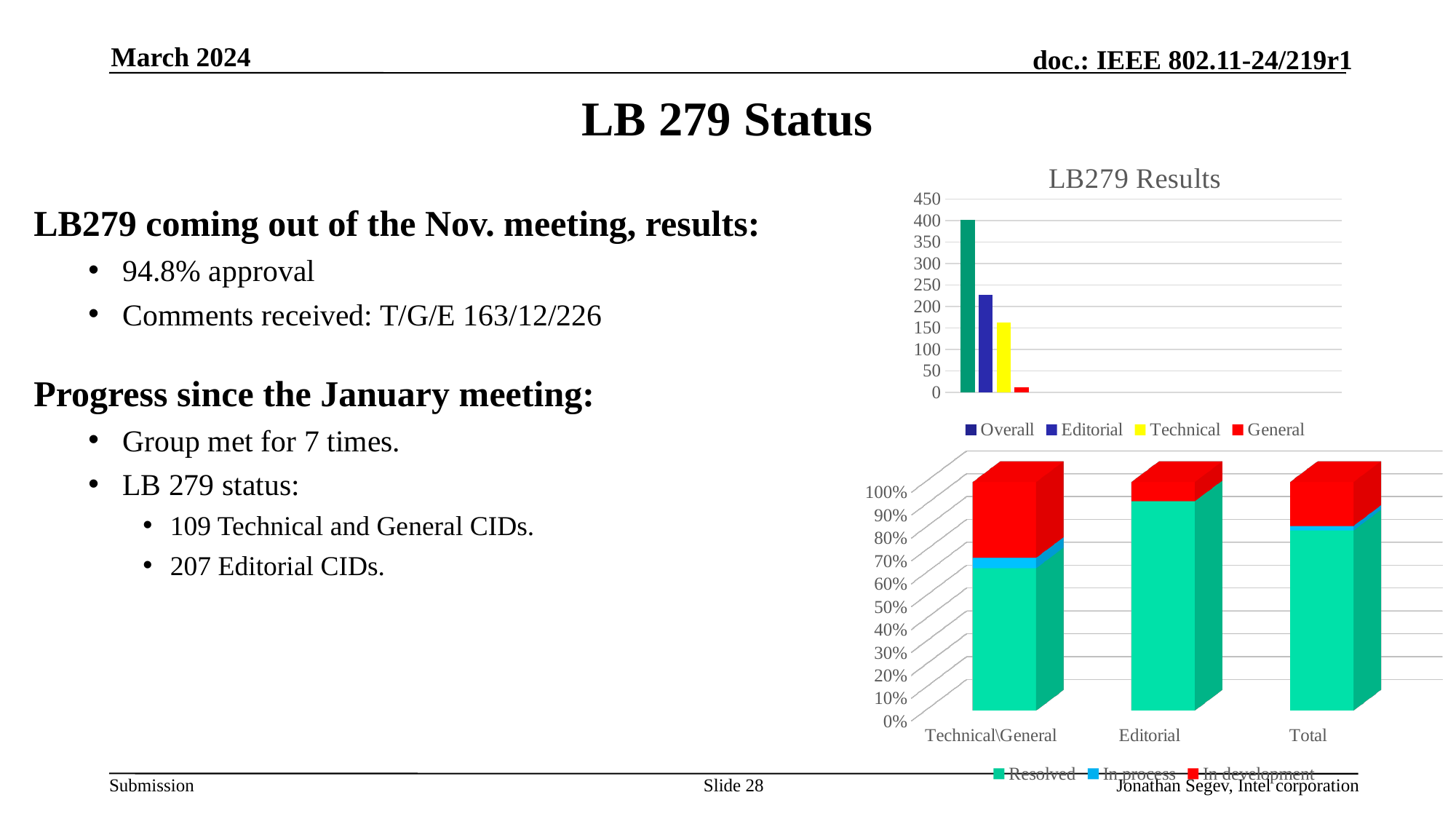
In the 'LB279 Results' chart, which is larger, Editorial or Technical? Editorial In the 'LB279 Results' chart, is the value for Editorial greater or less than 200? greater In the 'LB279 Results' chart, is the value for General greater or less than 50? less How many series does the legend of the 'LB279 Results' chart list? 4 In the 'LB279 Results' chart, which series has the lowest value? General In the 'LB279 Results' chart, which series has the highest value? Overall How many series does the legend of the stacked bar chart at the bottom right list? 3 In the 'LB279 Results' chart, what colour is the Technical bar? yellow What kind of chart is the 'LB279 Results' chart at the top right? bar chart In the stacked bar chart at the bottom right, which category has the largest Resolved share? Editorial How many categories are shown on the x axis of the stacked bar chart at the bottom right? 3